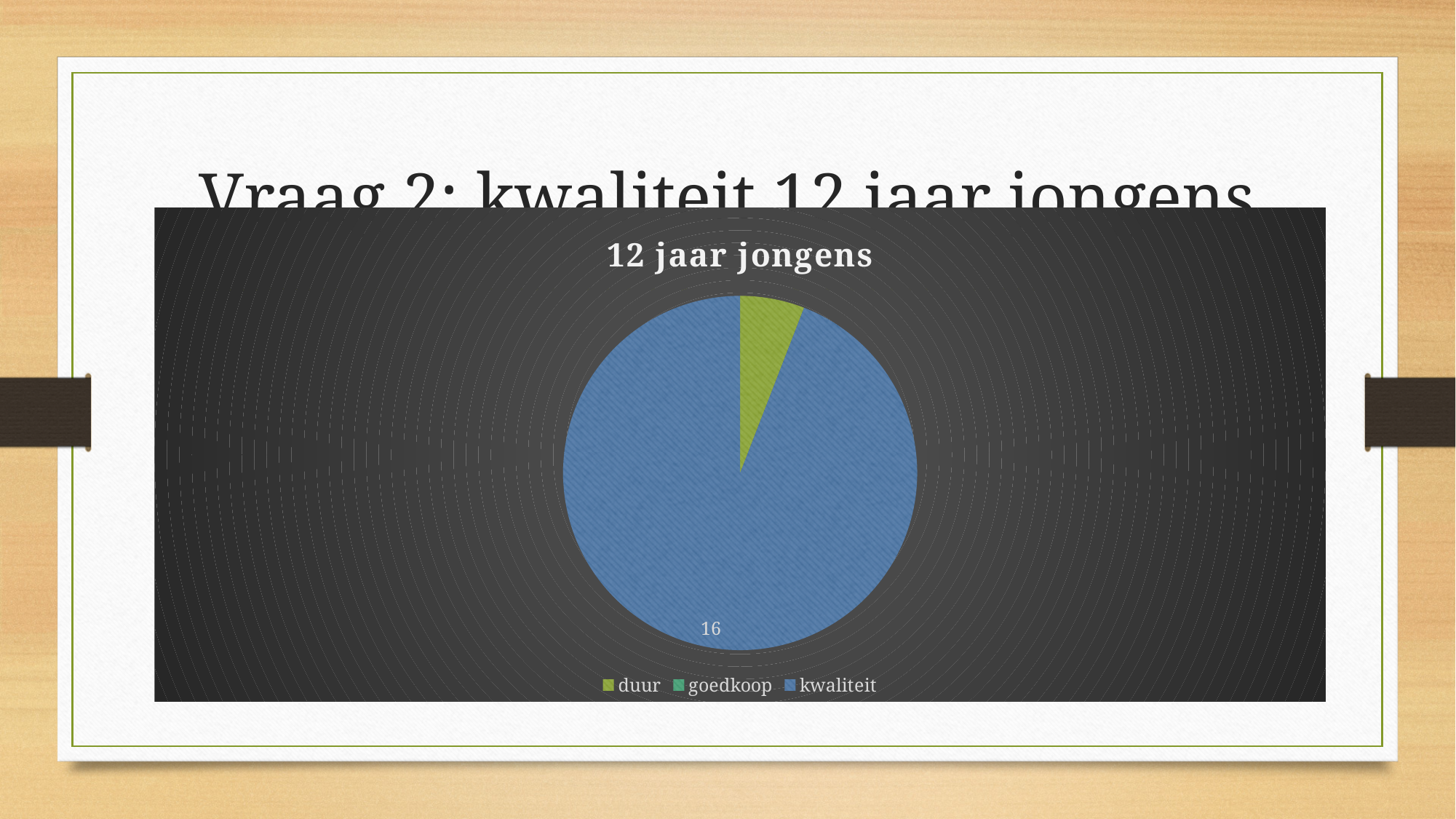
What value is printed on the kwaliteit slice of the pie chart? 16 What colour is the kwaliteit slice in the pie chart? blue What kind of chart is shown on the slide? pie chart Which category has the largest slice in the pie chart? kwaliteit What is the title of the chart? 12 jaar jongens Which legend entry is listed first in the chart's legend? duur Which slice is larger, duur or kwaliteit? kwaliteit How many categories does the legend of the chart list? 3